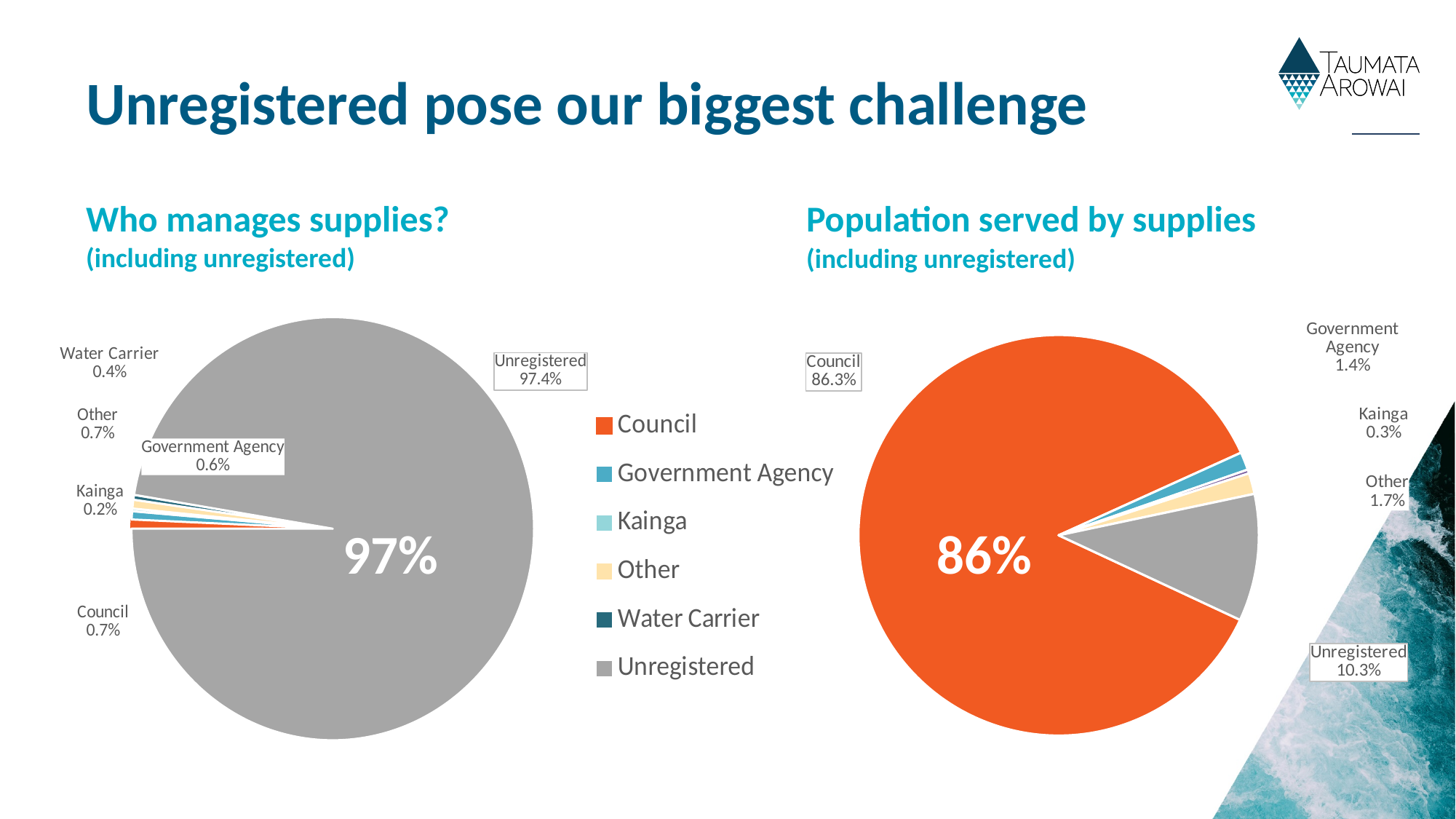
In the 'Population served by supplies' chart, what share is Council? 86.3% In the 'Population served by supplies' chart, what share is Other? 1.7% In the 'Who manages supplies?' chart, what share is Unregistered? 97.4% In the 'Who manages supplies?' chart, what share is Kainga? 0.2% How many entries does the shared legend list? 6 In the 'Population served by supplies' chart, what share is Unregistered? 10.3% In the 'Population served by supplies' chart, which is larger: Government Agency or Kainga? Government Agency In the 'Who manages supplies?' chart, which category has the smallest share? Kainga In the 'Who manages supplies?' chart, what share is Government Agency? 0.6% In the 'Who manages supplies?' chart, which category has the largest share? Unregistered In the 'Population served by supplies' chart, what is the difference between the Council share and the Unregistered share? 76.0 percentage points In the 'Population served by supplies' chart, which category has the largest share? Council